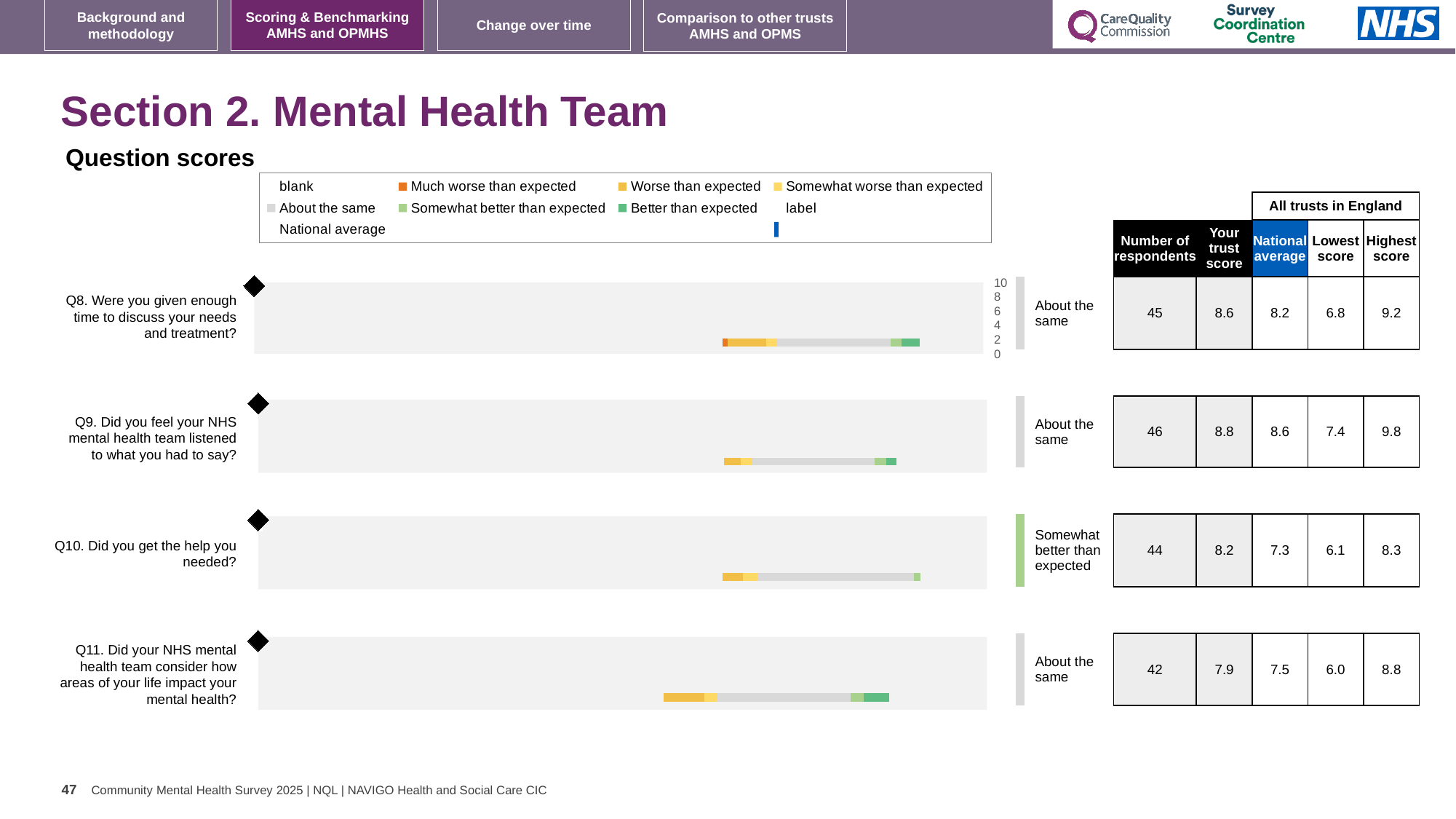
How many questions (Q8 to Q11) have a bar chart on the slide? 4 What is the national average score for Q9 (Did you feel your NHS mental health team listened to what you had to say)? 8.6 For Q10, what is the difference between the trust score and the national average? 0.9 What is the lowest score among all trusts in England for Q11? 6.0 What is the 'Your trust score' for Q8 (Were you given enough time to discuss your needs and treatment)? 8.6 What kind of chart is used to show the question scores for Q8 to Q11? bar chart Which question has the highest 'Your trust score'? Q9 How many respondents answered Q10 (Did you get the help you needed)? 44 What benchmark category is shown next to the Q10 chart? Somewhat better than expected What is the highest score among all trusts in England for Q10? 8.3 For Q8, which is larger: the trust score or the national average? the trust score Which question has the lowest 'Your trust score'? Q11